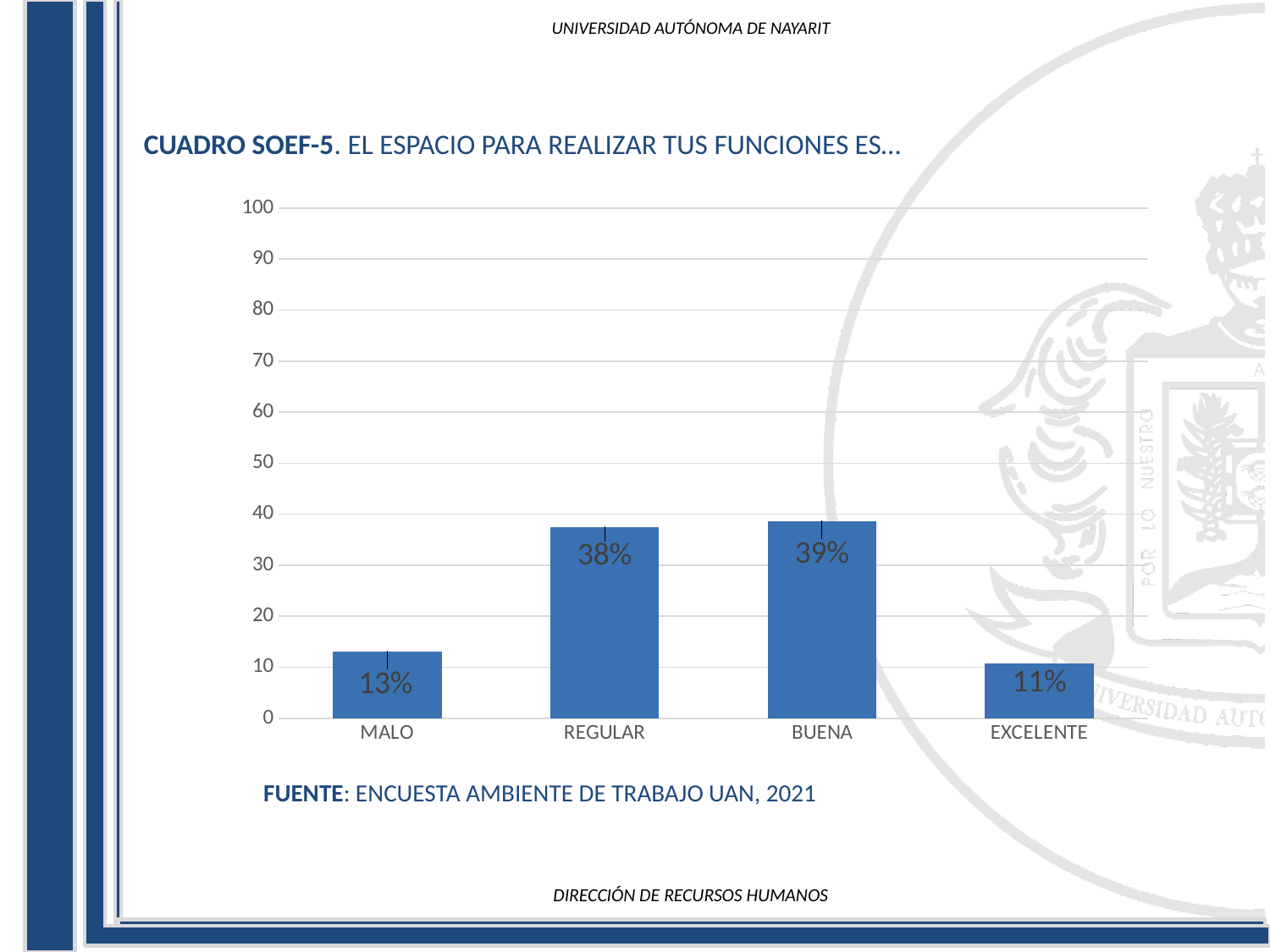
What source is cited below the chart? ENCUESTA AMBIENTE DE TRABAJO UAN, 2021 How many categories are shown on the x axis? 4 Is the value for BUENA greater or less than 30? greater What is the difference between the values for BUENA and MALO? 26% What is the difference between the values for MALO and EXCELENTE? 2% Which category has the lowest value? EXCELENTE What is the value for MALO? 13% What is the value for EXCELENTE? 11% What is the value for REGULAR? 38% Which is larger, the value for REGULAR or the value for EXCELENTE? REGULAR Which category has the highest value? BUENA What kind of chart is shown on the slide? bar chart